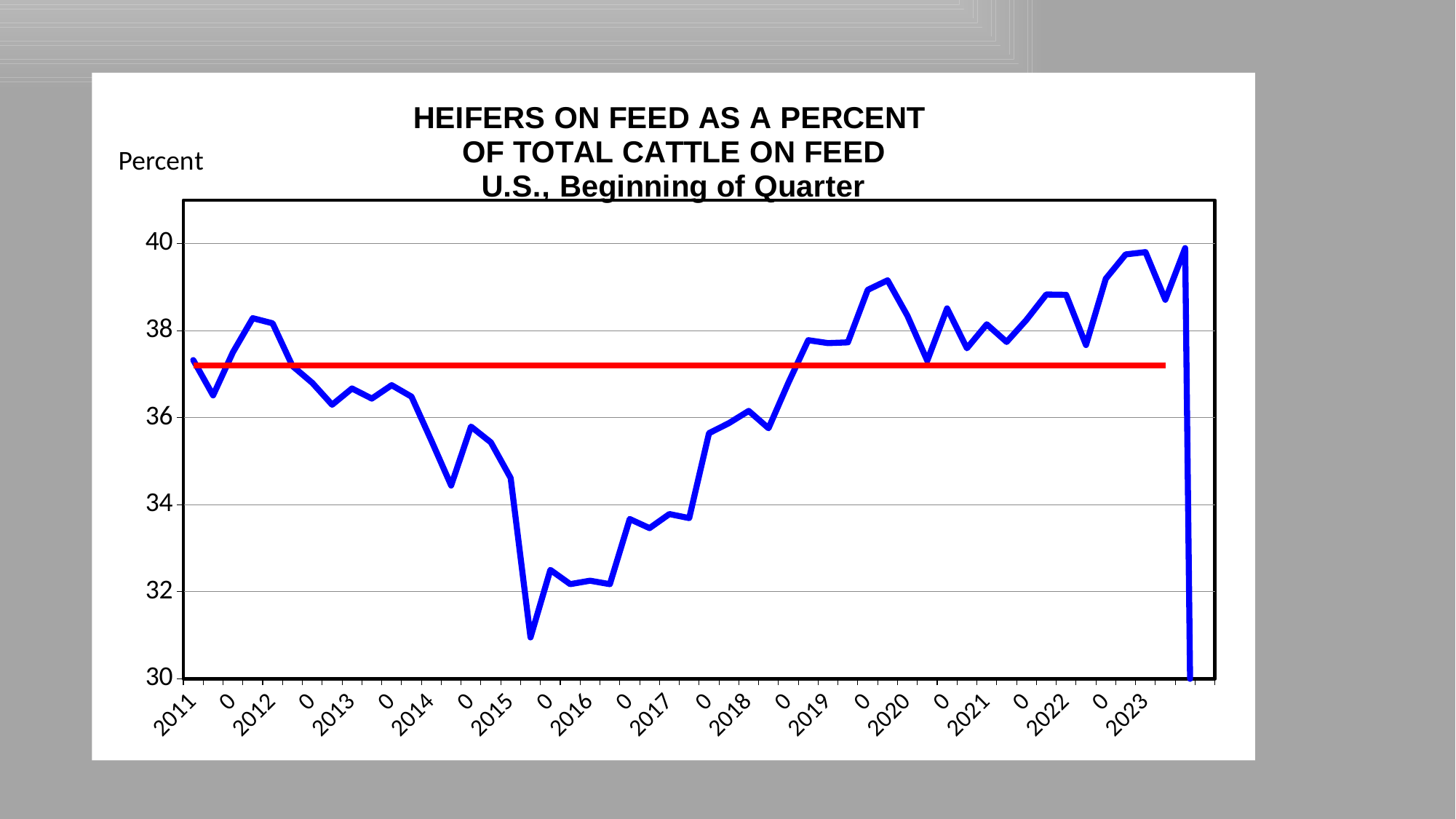
What kind of chart is shown on the slide? line chart Is the value at the beginning of 2020 greater or less than 38? greater How many years are labelled along the x axis of the chart? 13 Is the value at the beginning of 2023 greater or less than 38? greater Is the value at the beginning of 2017 greater or less than 36? less Does the line generally rise or fall from 2011 to 2016? fall Does the line generally rise or fall from 2016 to 2020? rise What is the title of the chart? HEIFERS ON FEED AS A PERCENT OF TOTAL CATTLE ON FEED U.S., Beginning of Quarter What label is shown on the vertical axis of the chart? Percent Which is larger, the value at the beginning of 2020 or the value at the beginning of 2016? 2020